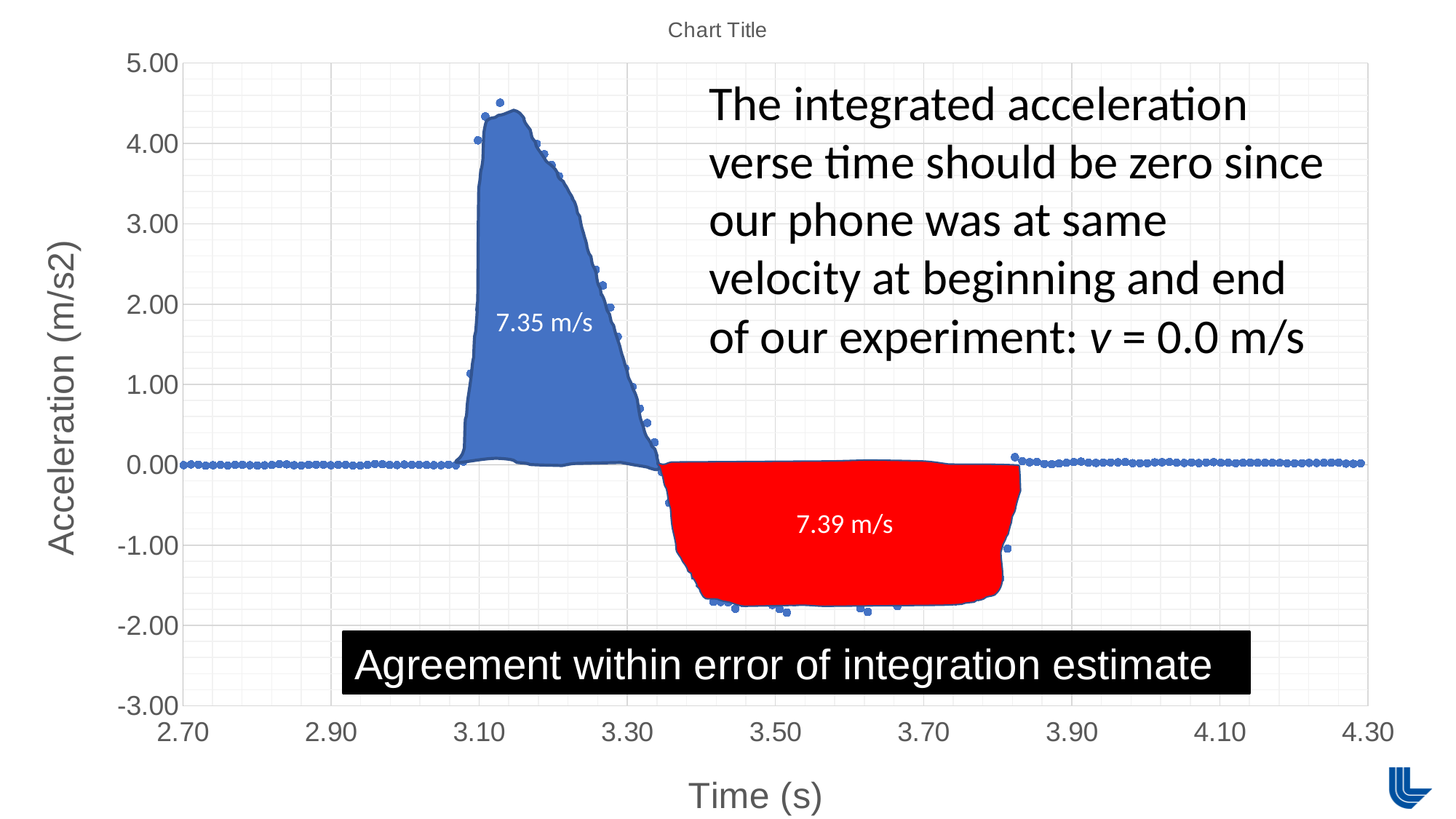
Between 3.10 s and 3.30 s, does the acceleration rise or fall along the x axis? fall What is the difference between the values printed on the red and blue shaded regions? 0.04 m/s What is the label printed on the blue shaded region of the chart? 7.35 m/s Is the acceleration at 2.90 s greater or less than 1.00 m/s2? less What is the highest value shown on the vertical axis of the chart? 5.00 What kind of chart is shown on the slide? Scatter chart with a line Is the acceleration around 3.50 s greater or less than -1.00 m/s2? less What is the label on the horizontal axis of the chart? Time (s) Which shaded region has the larger printed value, the blue one or the red one? Red (7.39 m/s) What is the label printed on the red shaded region of the chart? 7.39 m/s What is the label on the vertical axis of the chart? Acceleration (m/s2) Is the peak acceleration around 3.10 s greater or less than 4.00 m/s2? greater